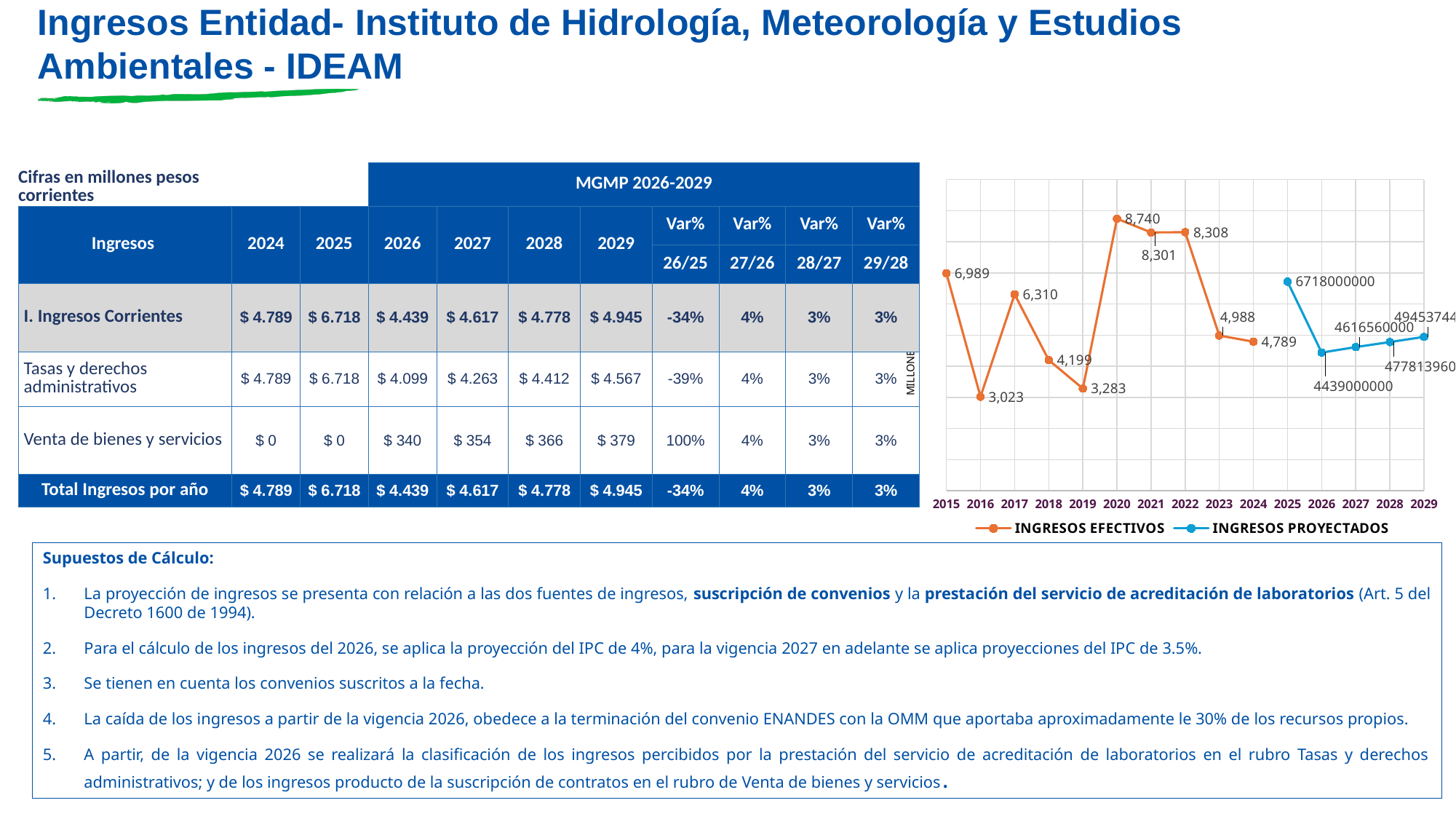
What is the difference between the INGRESOS EFECTIVOS values for 2020 and 2019? 5,457 What is the value of INGRESOS PROYECTADOS for 2025 in the chart? 6718000000 What is the value of INGRESOS EFECTIVOS for 2020 in the chart? 8,740 What kind of chart is shown on the right of the slide? line chart Which year has the higher INGRESOS EFECTIVOS value, 2015 or 2017? 2015 What is the value of INGRESOS EFECTIVOS for 2016 in the chart? 3,023 What are the two series named in the chart legend? INGRESOS EFECTIVOS and INGRESOS PROYECTADOS In which year does the INGRESOS EFECTIVOS series reach its highest value? 2020 How many years are shown on the x axis of the chart? 15 In which year does the INGRESOS EFECTIVOS series reach its lowest value? 2016 What is the value of INGRESOS PROYECTADOS for 2026 in the chart? 4439000000 How many series does the chart legend list? 2